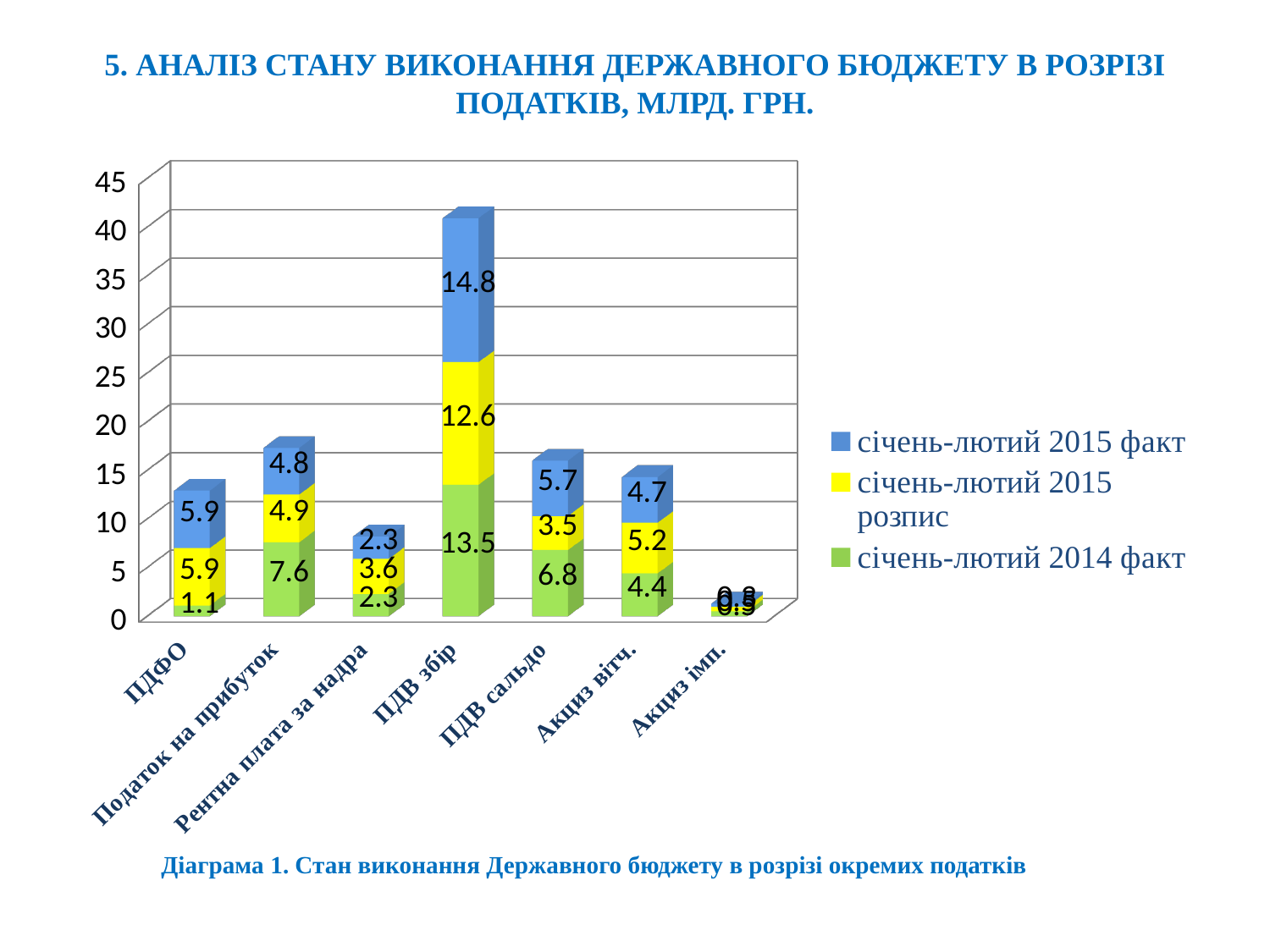
What is the value for ПДВ збір in the січень-лютий 2015 факт series? 14.8 Is the total stacked bar for ПДВ збір greater or less than 35? greater What is the difference between the січень-лютий 2015 факт and січень-лютий 2014 факт values for ПДВ збір? 1.3 How many series does the legend list? 3 How many categories are shown on the x axis? 7 Which category has the tallest stacked bar? ПДВ збір What is the value for Податок на прибуток in the січень-лютий 2014 факт series? 7.6 What is the total of the stacked bar for Рентна плата за надра? 8.2 Which category has the shortest stacked bar? Акциз імп. What is the value for Акциз вітч. in the січень-лютий 2015 розпис series? 5.2 Which is larger for ПДВ сальдо: the січень-лютий 2014 факт value or the січень-лютий 2015 розпис value? січень-лютий 2014 факт What kind of chart is shown on the slide? stacked bar chart